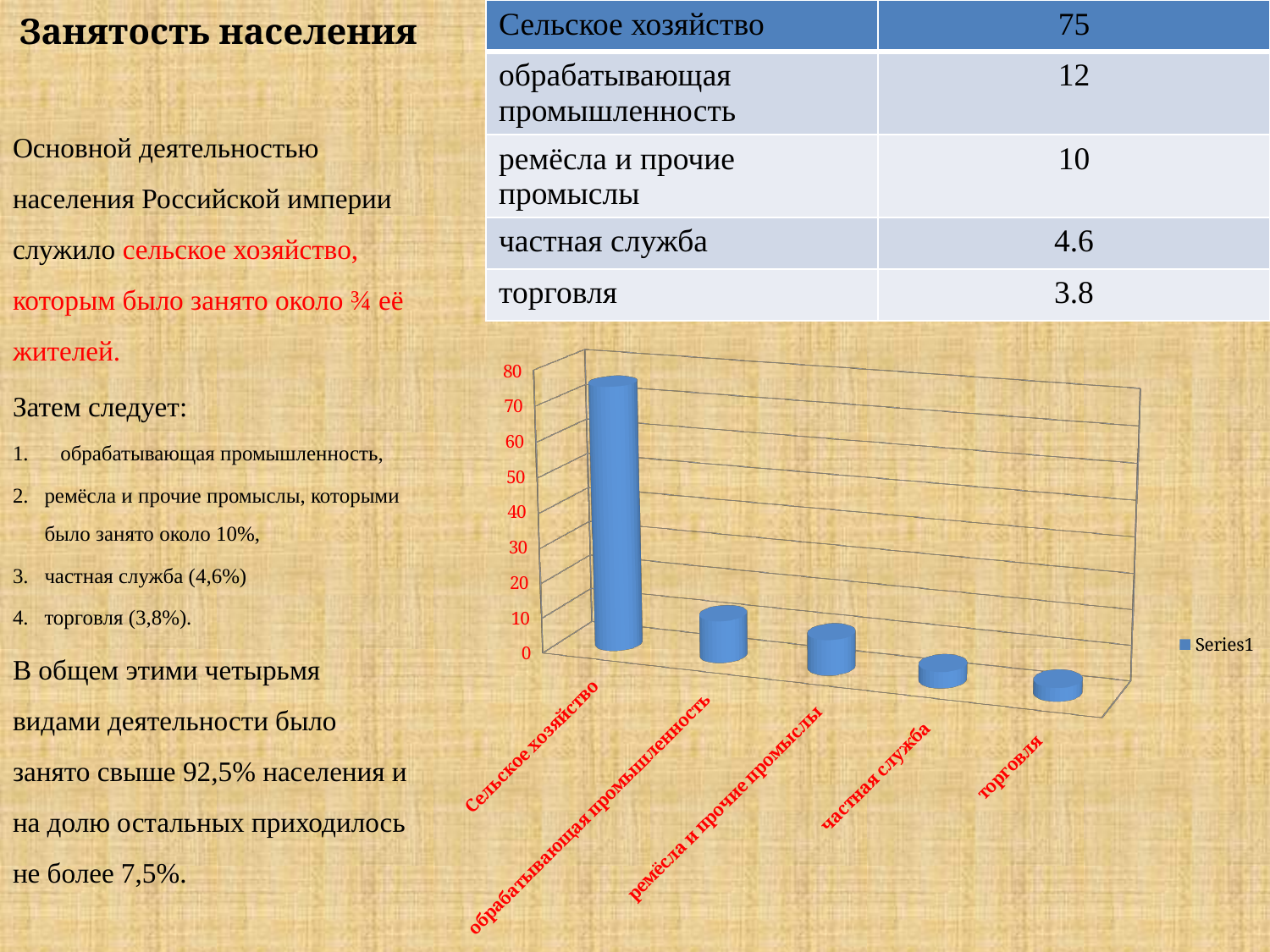
Which is larger, the bar for обрабатывающая промышленность or the bar for торговля? обрабатывающая промышленность Do the bar values rise or fall from left to right along the x axis? fall Is the value for частная служба greater or less than 10? less What is the name of the series shown in the chart legend? Series1 Which category has the highest bar in the chart? Сельское хозяйство Which category has the lowest bar in the chart? торговля What type of chart is shown on the slide? bar chart How many categories are plotted on the chart? 5 Is the value for Сельское хозяйство greater or less than 70? greater According to the table above the chart, what is the value for ремёсла и прочие промыслы? 10 How many series does the chart legend list? 1 Is the value for обрабатывающая промышленность greater or less than 20? less